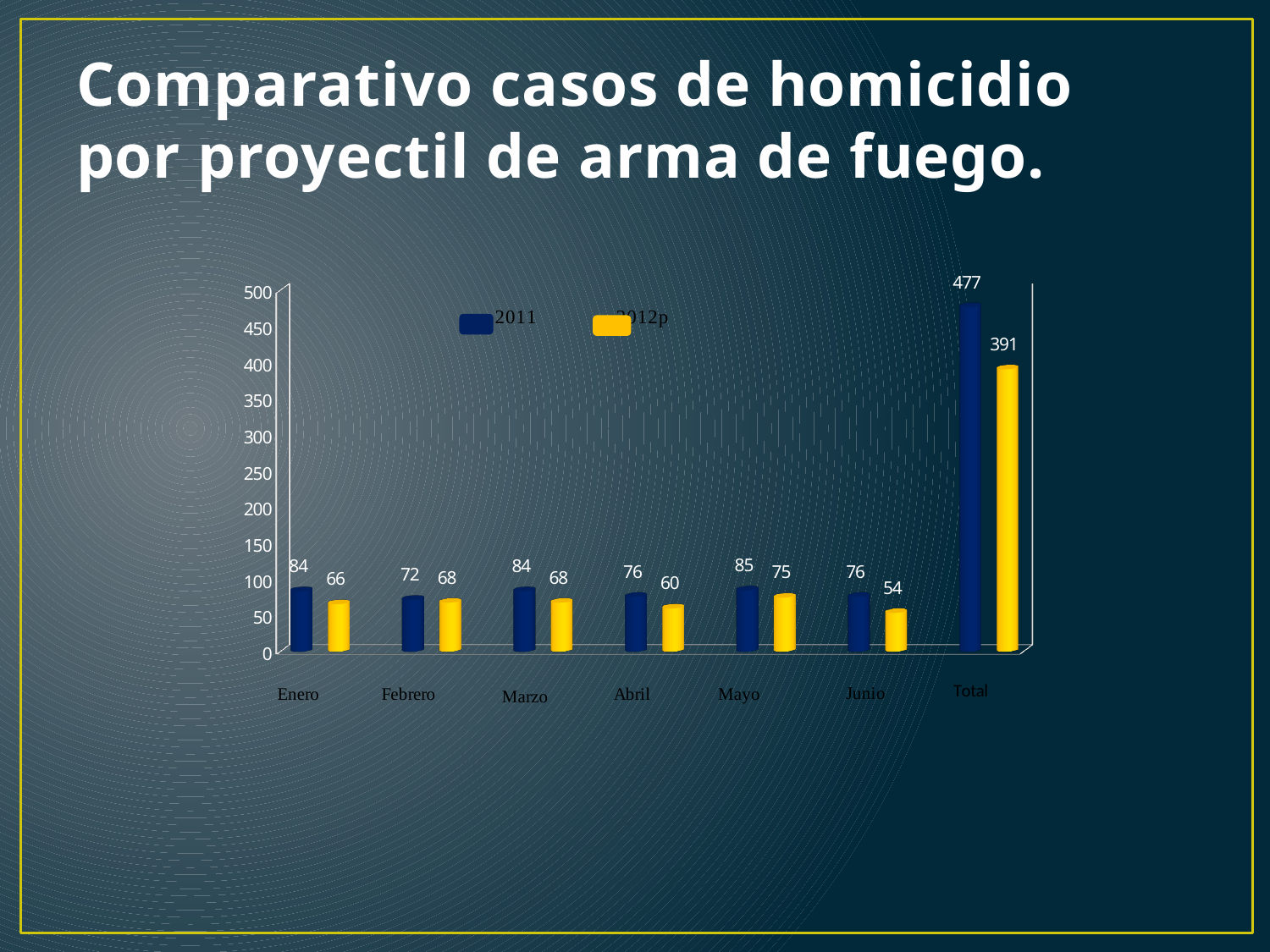
Which is larger for Febrero, the 2011 value or the 2012p value? 2011 What kind of chart is shown on the slide? Bar chart What is the difference between the 2011 and 2012p values for Total? 86 How many series does the legend list? 2 What is the 2012p value for Junio? 54 What is the 2011 value for Enero? 84 What is the 2011 value for Total? 477 Which month has the lowest 2012p value (excluding Total)? Junio Which month has the highest 2011 value (excluding Total)? Mayo How many categories are shown on the x axis? 7 What is the difference between the 2011 and 2012p values for Abril? 16 What colour are the bars for the 2012p series? Yellow